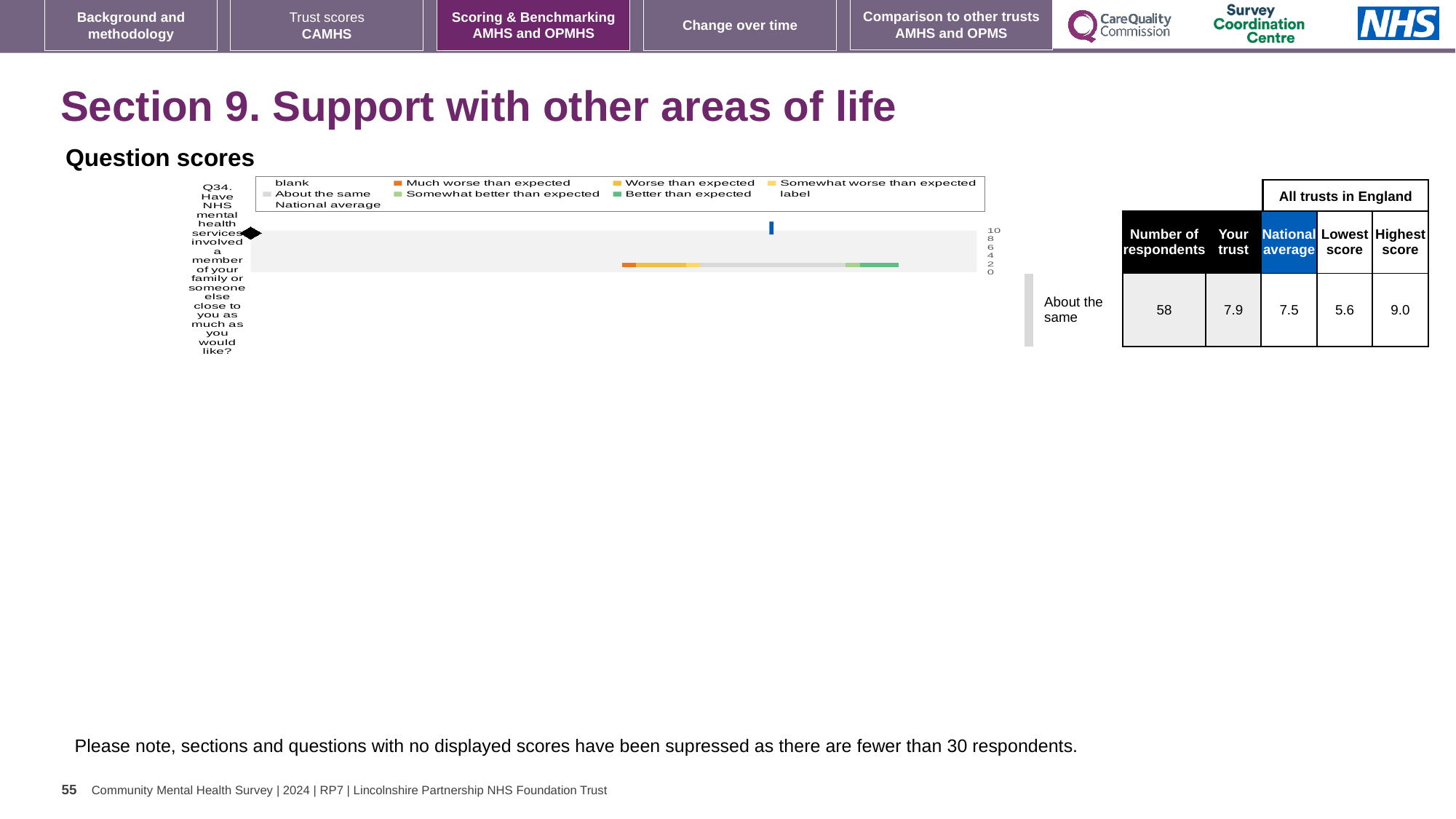
How many questions (categories) are plotted in the Question scores chart? 1 According to the table beside the chart, what is the 'Your trust' score for Q34? 7.9 In the Question scores chart legend, what colour represents 'Much worse than expected'? orange What kind of chart is shown under 'Question scores'? bar chart Which question number is plotted in the Question scores chart? Q34 For Q34, what is the difference between the 'Your trust' score and the national average? 0.4 For Q34, what is the difference between the highest and lowest scores among all trusts in England? 3.4 According to the table beside the chart, what is the number of respondents for Q34? 58 According to the table beside the chart, what is the highest score among all trusts in England for Q34? 9.0 According to the table beside the chart, what is the national average score for Q34? 7.5 According to the table beside the chart, what is the lowest score among all trusts in England for Q34? 5.6 For Q34, which is larger: the 'Your trust' score or the national average? Your trust